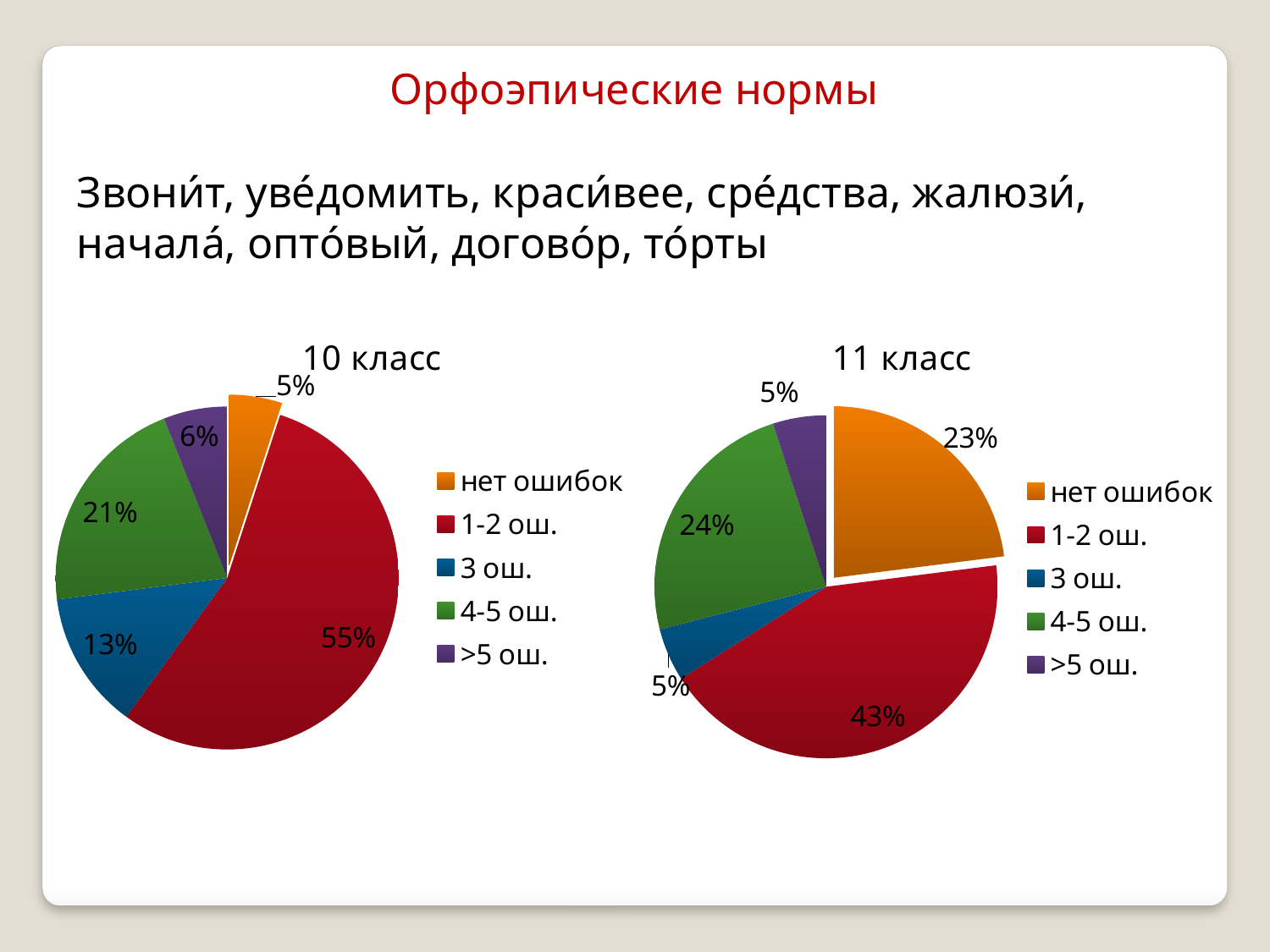
What type of chart is used for "11 класс"? Pie chart In the "11 класс" pie chart, which category has the largest slice? 1-2 ош. In the "10 класс" pie chart, which category has the smallest slice? нет ошибок In the "11 класс" pie chart, what share is labelled for "нет ошибок"? 23% In the "11 класс" pie chart, what share is labelled for "3 ош."? 5% In the "10 класс" pie chart, what share is labelled for "1-2 ош."? 55% What is the difference between the "1-2 ош." share in the "10 класс" chart and the "1-2 ош." share in the "11 класс" chart? 12% How many categories does the legend of the "10 класс" chart list? 5 In the "10 класс" pie chart, which category has the largest slice? 1-2 ош. Which is larger: the "нет ошибок" share in the "10 класс" chart or in the "11 класс" chart? 11 класс In the "11 класс" pie chart, what share is labelled for "4-5 ош."? 24% In the "10 класс" pie chart, what share is labelled for "4-5 ош."? 21%